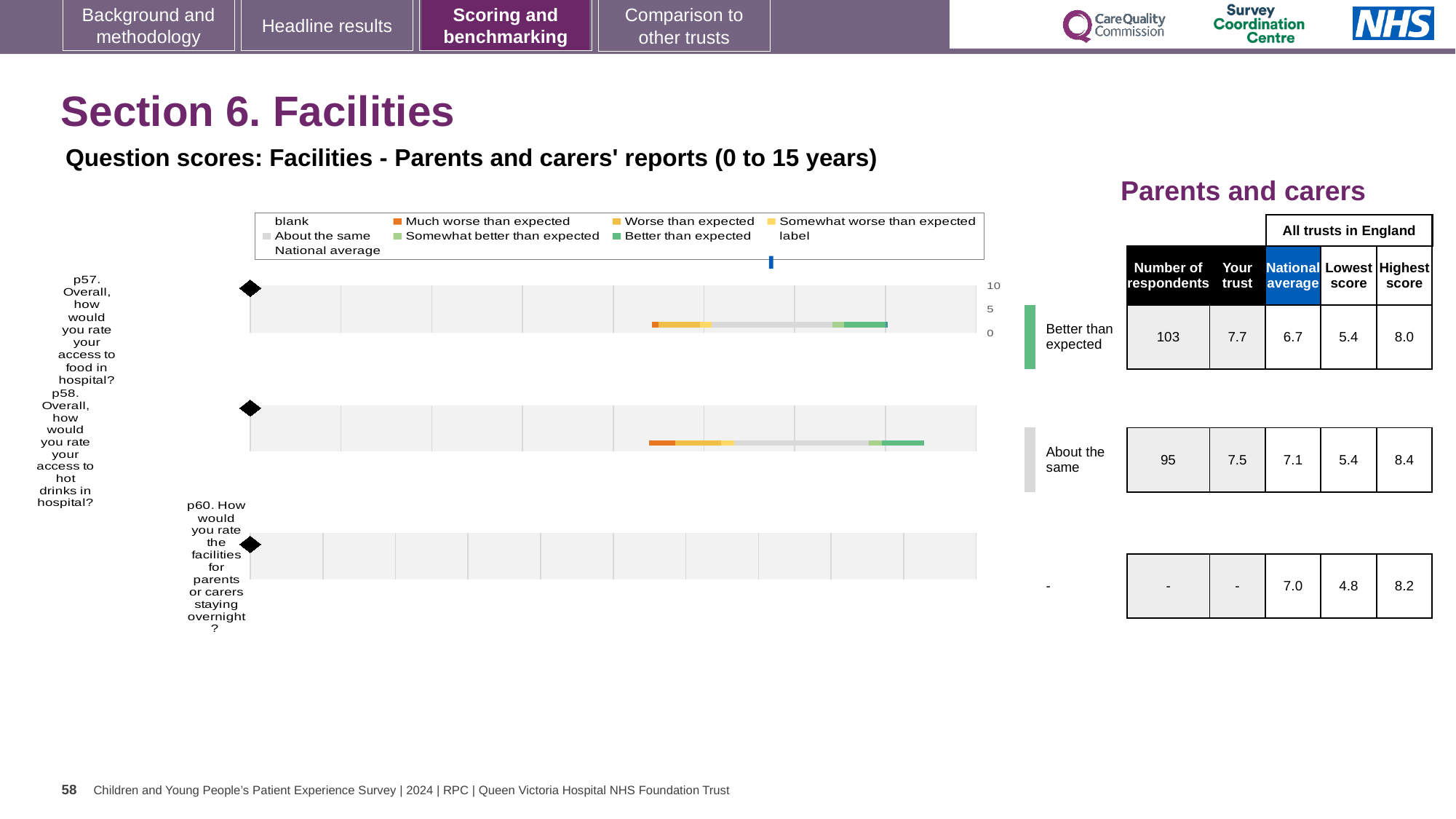
According to the table beside the chart, what is the national average for p58 (access to hot drinks in hospital)? 7.1 According to the table beside the chart, what is the "Your trust" score for p57 (access to food in hospital)? 7.7 In the chart legend, what colour represents "Much worse than expected"? orange Which of the three questions has the highest "Highest score" value in the table beside the chart? p58 (access to hot drinks in hospital) How many survey questions (categories) are plotted in the chart? 3 For p57 (access to food in hospital), what is the difference between the "Your trust" score and the national average? 1.0 What kind of chart is shown on the slide? bar chart According to the table beside the chart, how many respondents answered p57 (access to food in hospital)? 103 For p57 (access to food in hospital), which is larger: the "Your trust" score or the national average? Your trust In the chart legend, what colour represents "Better than expected"? green What benchmark category is shown for p57 (access to food in hospital)? Better than expected According to the table beside the chart, what is the lowest score for p60 (facilities for parents or carers staying overnight)? 4.8